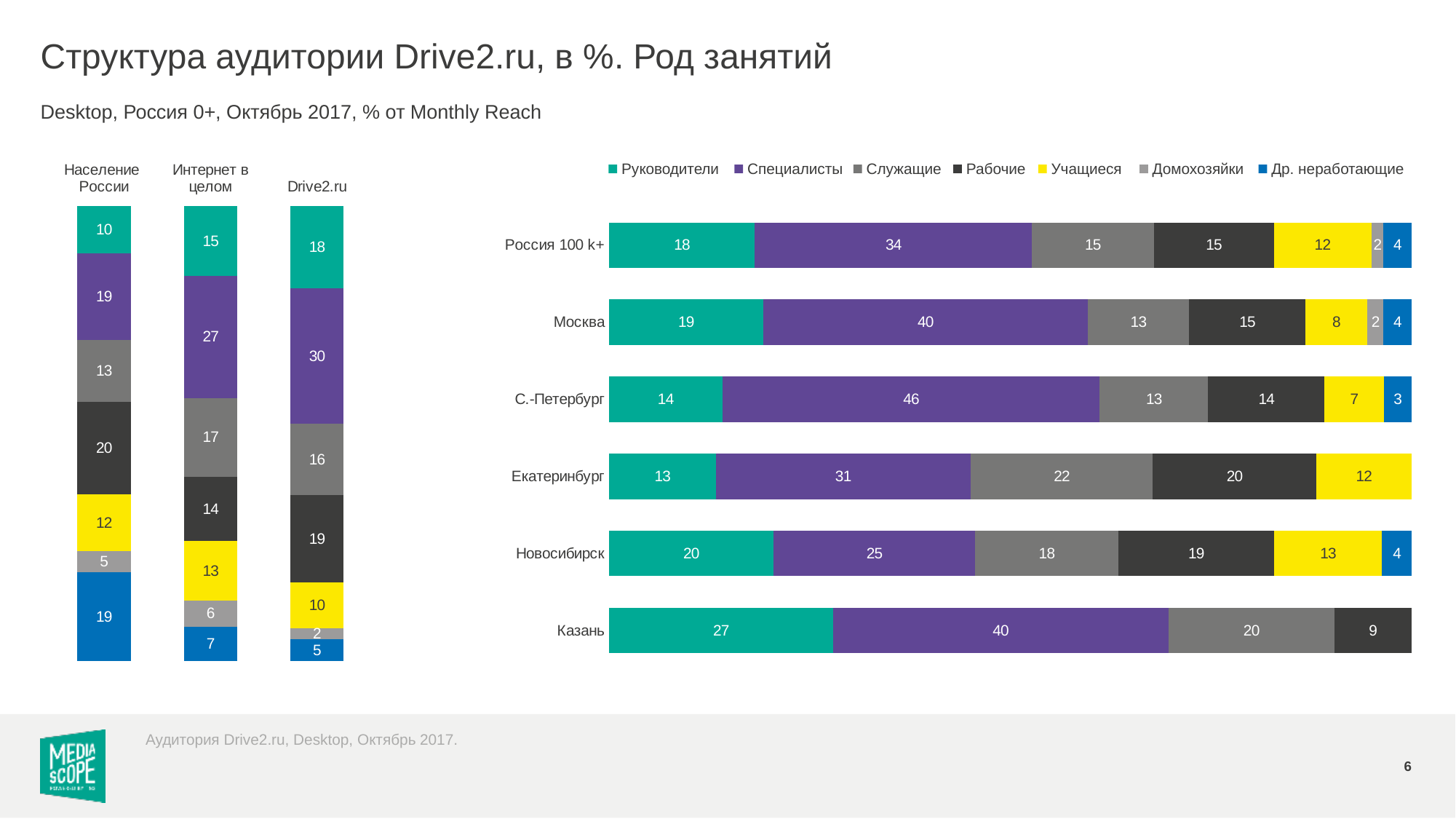
Which legend entry is shown in yellow? Учащиеся In the right-hand chart (by city), which city has the highest value for Специалисты? С.-Петербург In the right-hand chart (by city), which city has the lowest value for Руководители? Екатеринбург How many series does the legend list? 7 In the right-hand chart (by city), what is the total of the Россия 100 k+ bar? 100 In the left-hand chart, what is the difference between the Рабочие value for Население России and for Drive2.ru? 1 What kind of chart is the right-hand chart (by city)? Stacked bar chart In the left-hand chart, what is the value for Специалисты in the Drive2.ru bar? 30 In the right-hand chart (by city), what is the value for Руководители in Казань? 27 In the right-hand chart (by city), what is the value for Специалисты in С.-Петербург? 46 How many cities/regions are shown in the right-hand chart? 6 In the right-hand chart (by city), which is larger: the Служащие value for Екатеринбург or for Москва? Екатеринбург